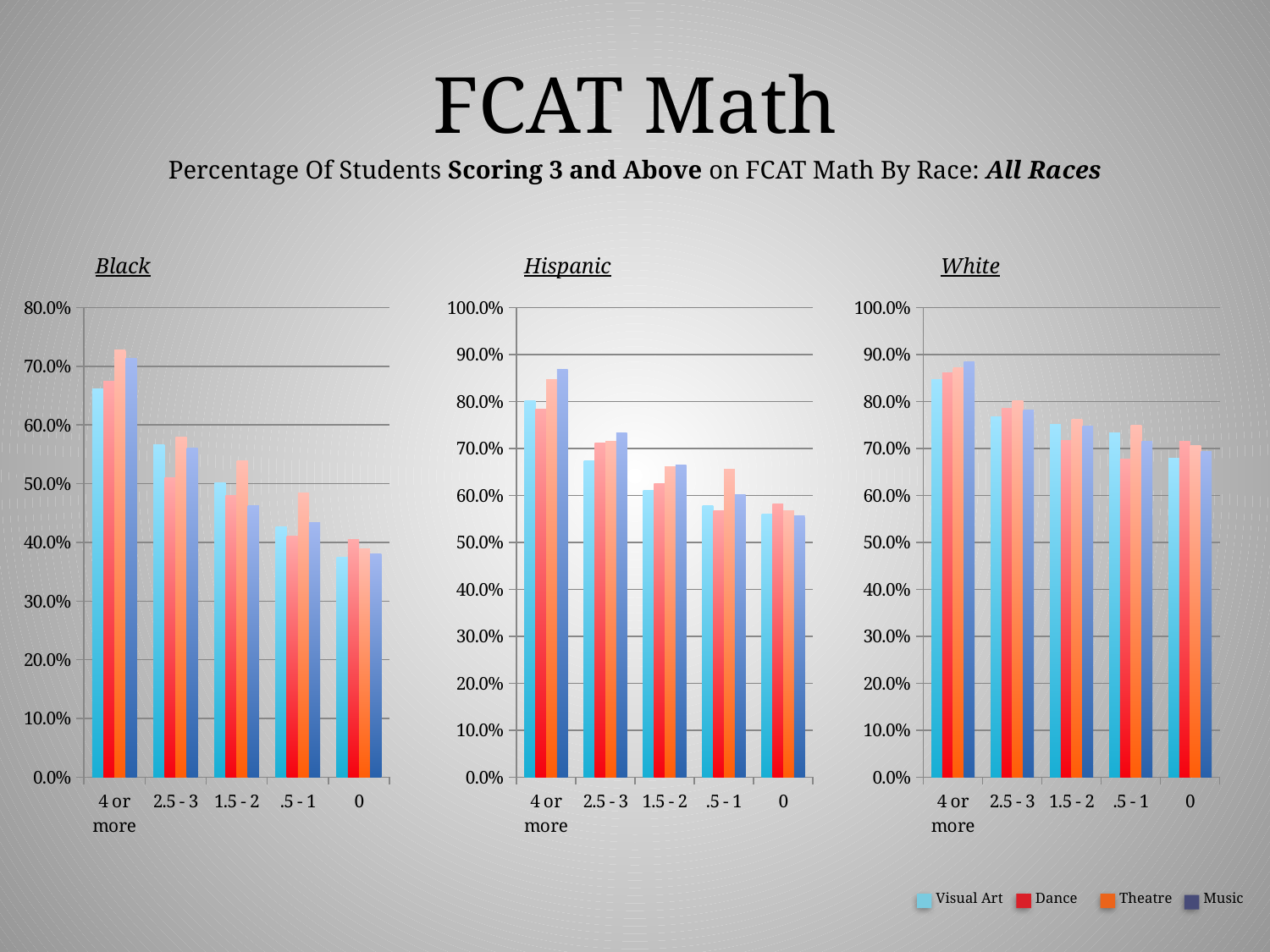
In the Black chart, is the Theatre value for '4 or more' greater or less than 70.0%? greater How many series does the legend list? 4 In the White chart, is the Visual Art value for '0' greater or less than 70.0%? less In the Black chart, do the Visual Art values rise or fall from '4 or more' to '0'? fall In the White chart, is the Music value for '4 or more' greater or less than 80.0%? greater How many categories are shown on the x axis of the Hispanic chart? 5 In the Black chart, which category has the highest Theatre value? 4 or more What kind of chart is the Black chart? bar chart In the Hispanic chart, for '4 or more', which is larger: Music or Visual Art? Music